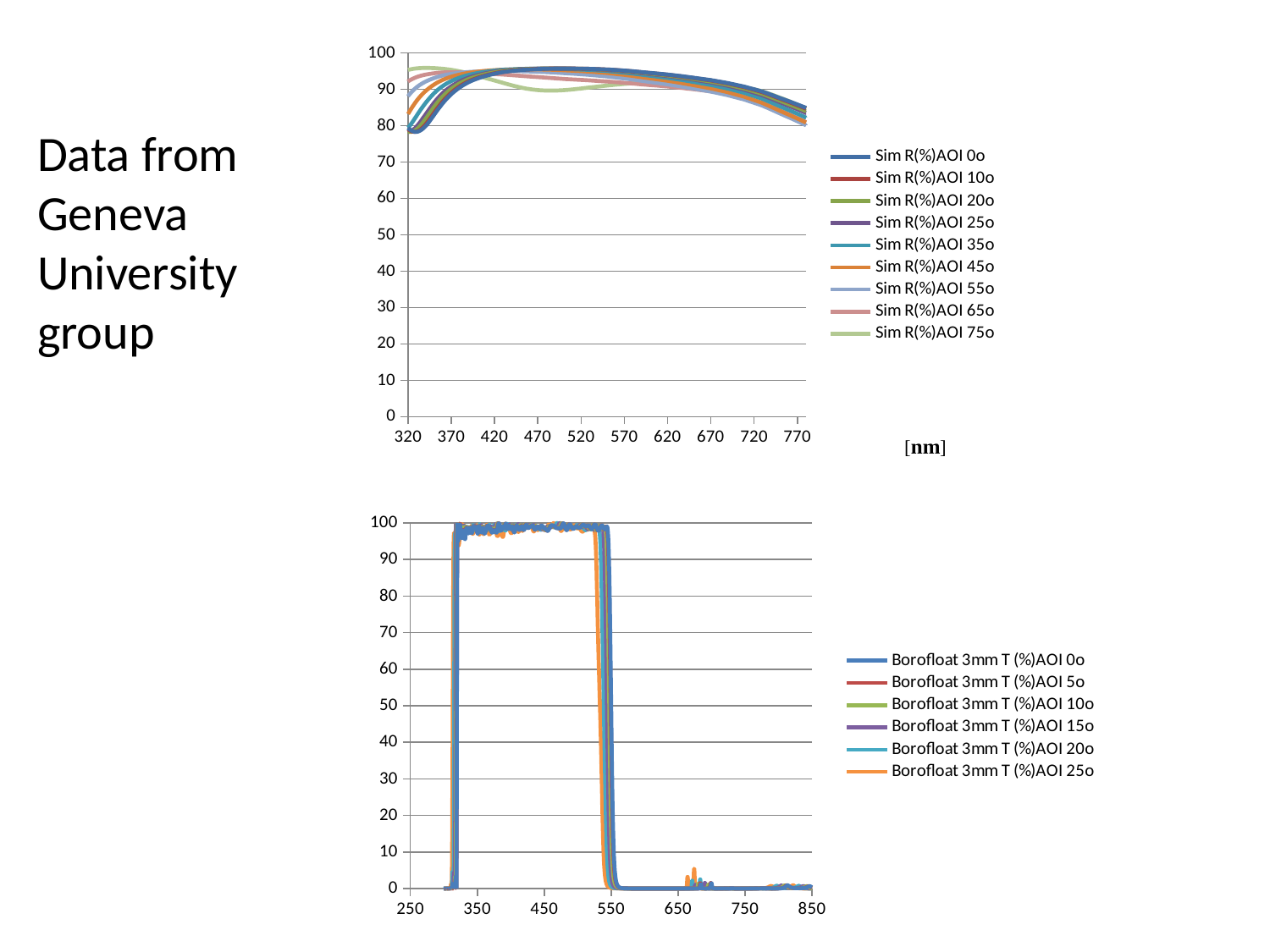
In the bottom chart, how many series does the legend list? 6 What kind of chart is the top chart? line chart In the top chart, is the value of Sim R(%)AOI 0o at 470 greater or less than 90? greater What is the last legend entry of the top chart? Sim R(%)AOI 75o In the top chart, is the value of Sim R(%)AOI 45o at 770 greater or less than 70? greater In the top chart, how many series does the legend list? 9 In the top chart, do the Sim R(%)AOI 0o values rise or fall between 520 and 770? fall In the bottom chart, do the Borofloat 3mm T (%)AOI 0o values rise or fall between 450 and 650? fall In the bottom chart, is the value of Borofloat 3mm T (%)AOI 0o at 750 greater or less than 10? less What kind of chart is the bottom chart? line chart What unit is shown for the x axis of the top chart? [nm]